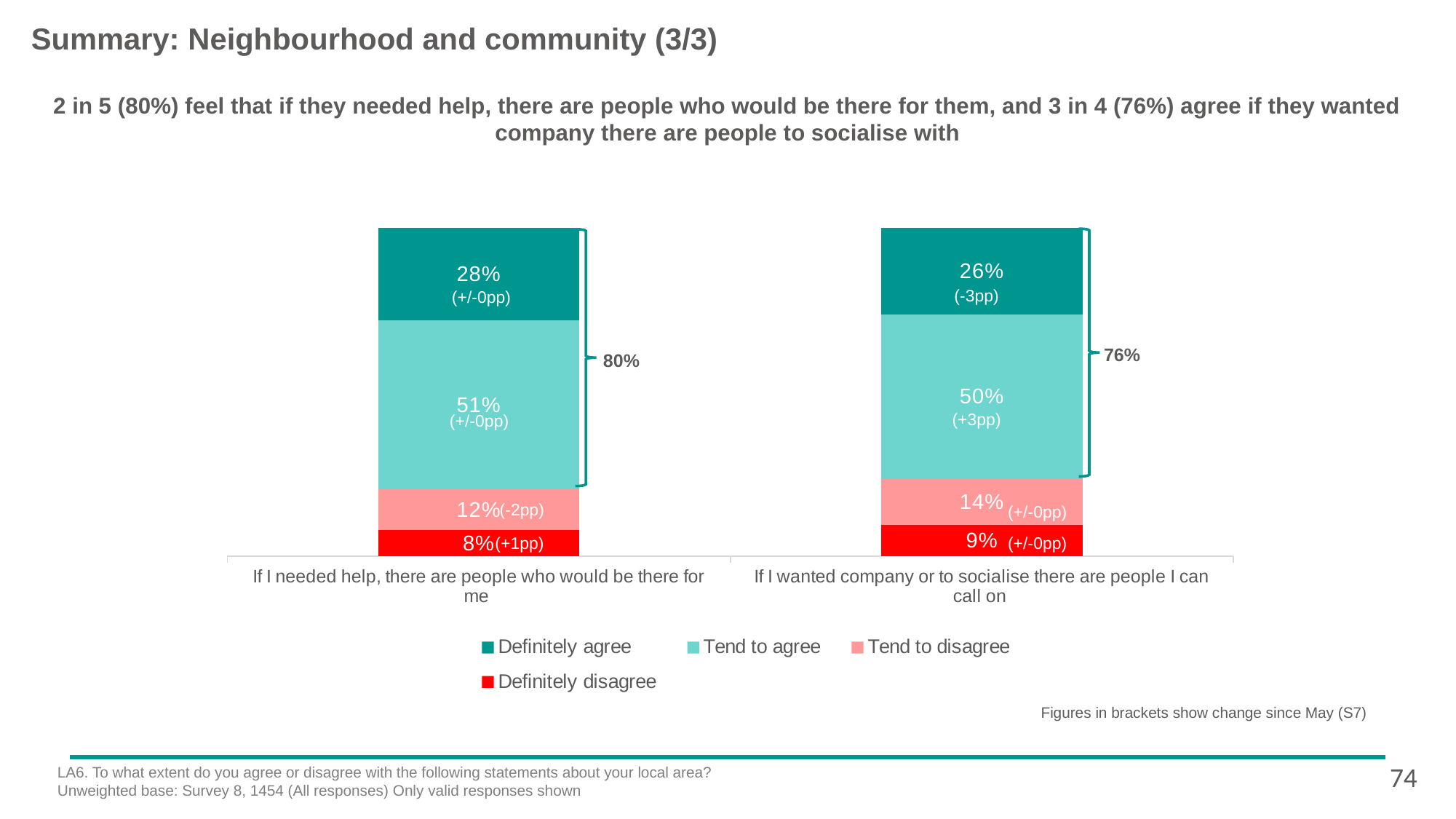
What percentage 'Definitely disagree' with the statement 'If I needed help, there are people who would be there for me'? 8% What is the combined agree figure shown by the bracket for 'If I needed help, there are people who would be there for me'? 80% What is the combined agree figure shown by the bracket for 'If I wanted company or to socialise there are people I can call on'? 76% Which statement has the larger 'Definitely agree' share? If I needed help, there are people who would be there for me How many statements (categories) are shown on the x axis? 2 How many series does the legend list? 4 What percentage 'Definitely agree' with the statement 'If I needed help, there are people who would be there for me'? 28% What percentage 'Tend to agree' with the statement 'If I wanted company or to socialise there are people I can call on'? 50% What is the difference between the 'Tend to agree' values for the two statements? 1 percentage point Which response category is the largest segment in the bar for 'If I needed help, there are people who would be there for me'? Tend to agree What kind of chart is shown on the slide? Stacked bar chart What percentage 'Tend to disagree' with the statement 'If I wanted company or to socialise there are people I can call on'? 14%